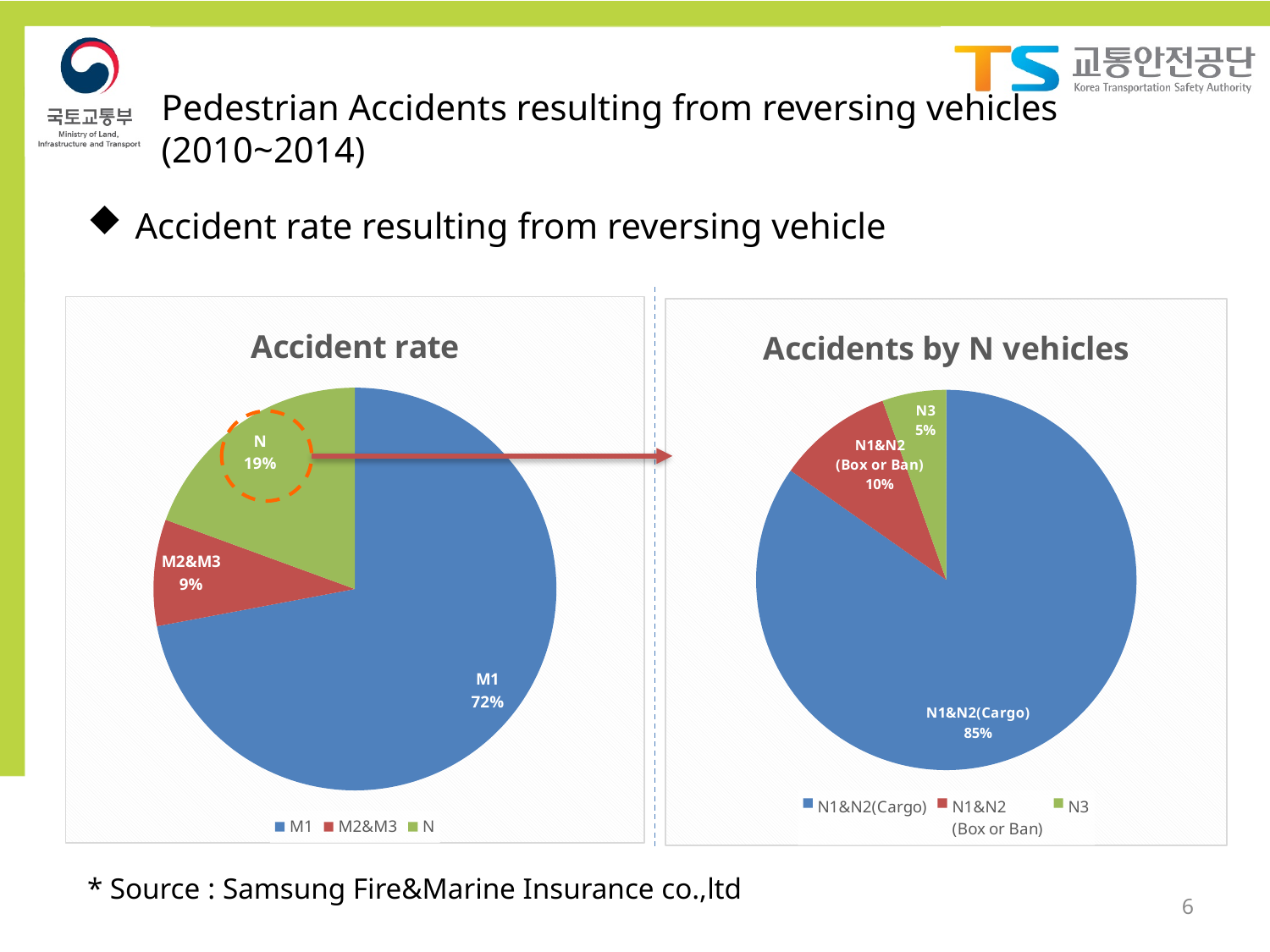
In the "Accidents by N vehicles" chart, what is the difference in percentage points between N1&N2 (Box or Ban) and N3? 5 In the "Accident rate" chart, what share of accidents is attributed to N vehicles? 19% In the "Accident rate" chart, which category has the smallest share? M2&M3 What kind of chart is the "Accident rate" chart? Pie chart In the "Accident rate" chart, what share of accidents is attributed to M1 vehicles? 72% In the "Accident rate" chart, how many categories does the legend list? 3 In the "Accidents by N vehicles" chart, which is larger: the share for N1&N2 (Box or Ban) or the share for N3? N1&N2 (Box or Ban) In the "Accidents by N vehicles" chart, which category has the largest share? N1&N2(Cargo) In the "Accidents by N vehicles" chart, what share is attributed to N1&N2(Cargo)? 85% In the "Accident rate" chart, what is the difference in percentage points between the M1 share and the N share? 53 In the "Accidents by N vehicles" chart, what share is attributed to N3? 5% In the "Accident rate" chart, which category is highlighted with a dashed orange circle? N